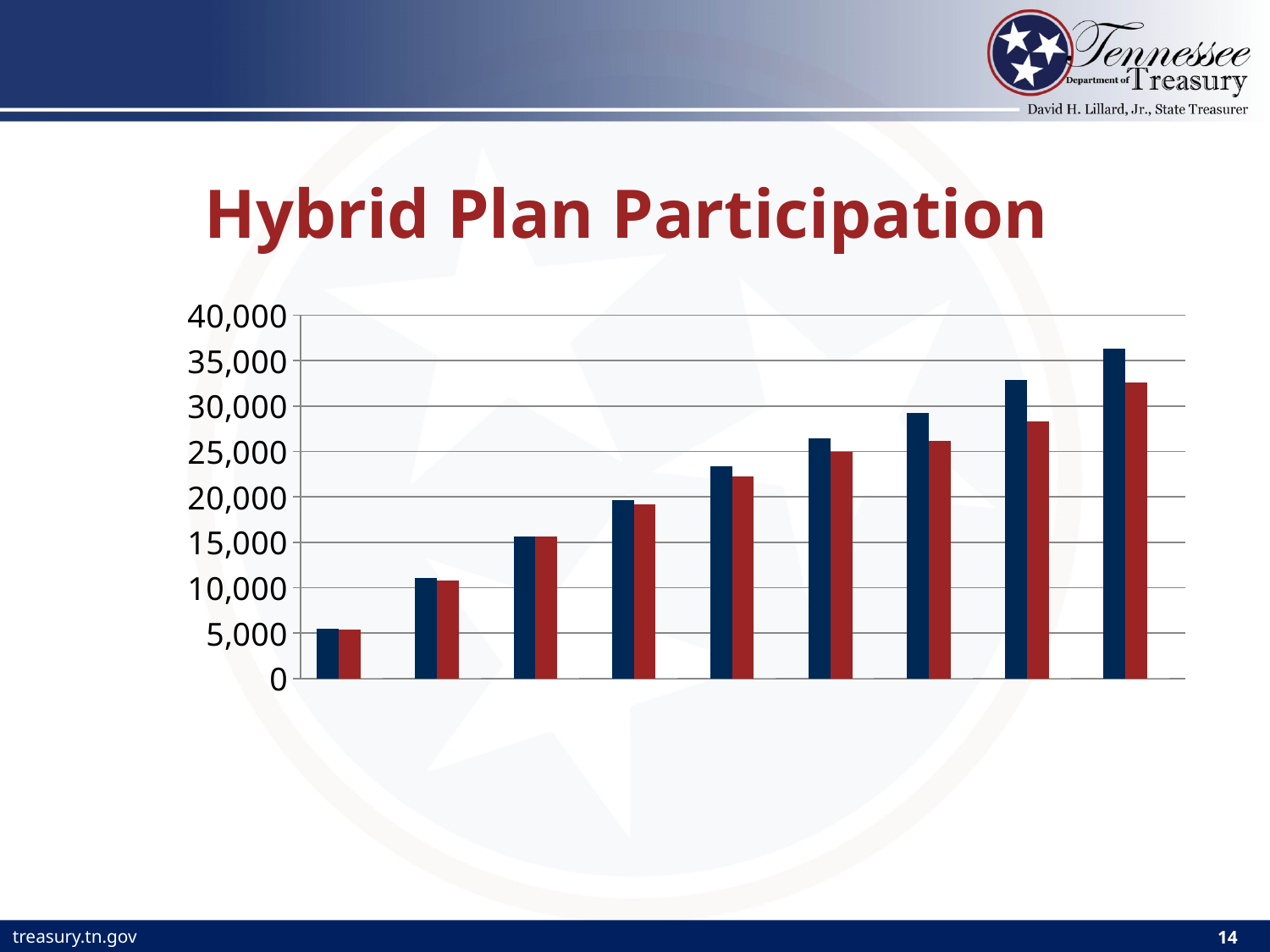
How many groups of bars are plotted along the x axis? 9 Which group of bars has the shortest bars, the leftmost or the rightmost? leftmost Is the value of the dark blue bar in the rightmost group greater or less than 35,000? greater Is the value of the dark blue bar in the fifth group from the left greater or less than 25,000? less Is the value of the red bar in the rightmost group greater or less than 30,000? greater What kind of chart is shown on the slide? bar chart What is the title of the slide containing the chart? Hybrid Plan Participation In the rightmost group, which bar is taller, the dark blue bar or the red bar? dark blue bar Which group of bars has the tallest bars, the leftmost or the rightmost? rightmost Do the bar heights generally rise or fall from left to right along the x axis? rise